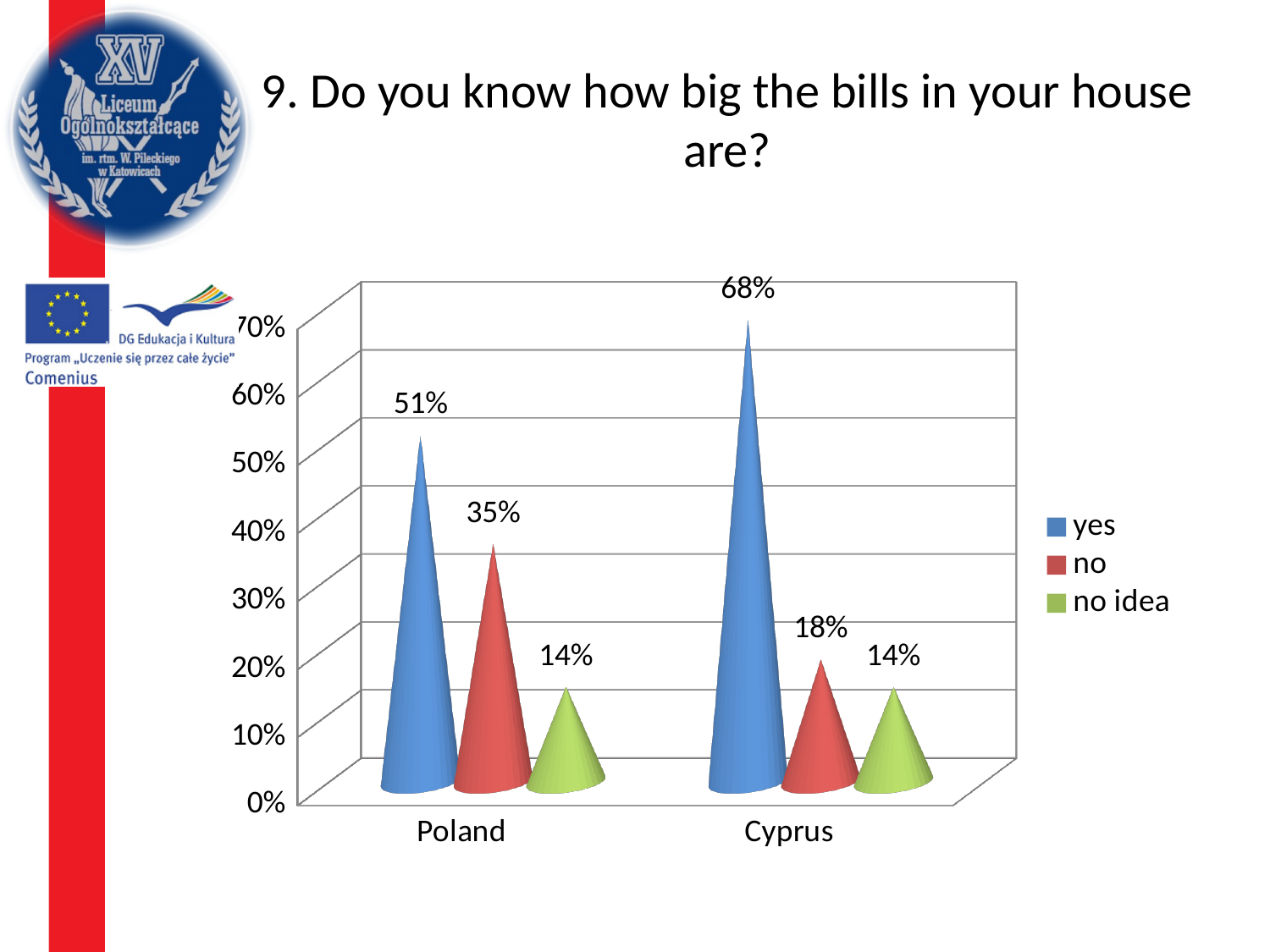
What percentage of respondents in Cyprus answered "no"? 18% Which response has the lowest value for Cyprus? no idea What is the difference between the "yes" and "no" values for Poland? 16% How many countries are shown on the x axis? 2 Which response has the highest value for Poland? yes What percentage of respondents in Poland answered "no idea"? 14% What is the difference between the "no" values for Poland and Cyprus? 17% What percentage of respondents in Poland answered "yes"? 51% What colour represents the "no idea" series? Green Which country has the higher "yes" value? Cyprus What percentage of respondents in Cyprus answered "yes"? 68% How many series does the legend list? 3